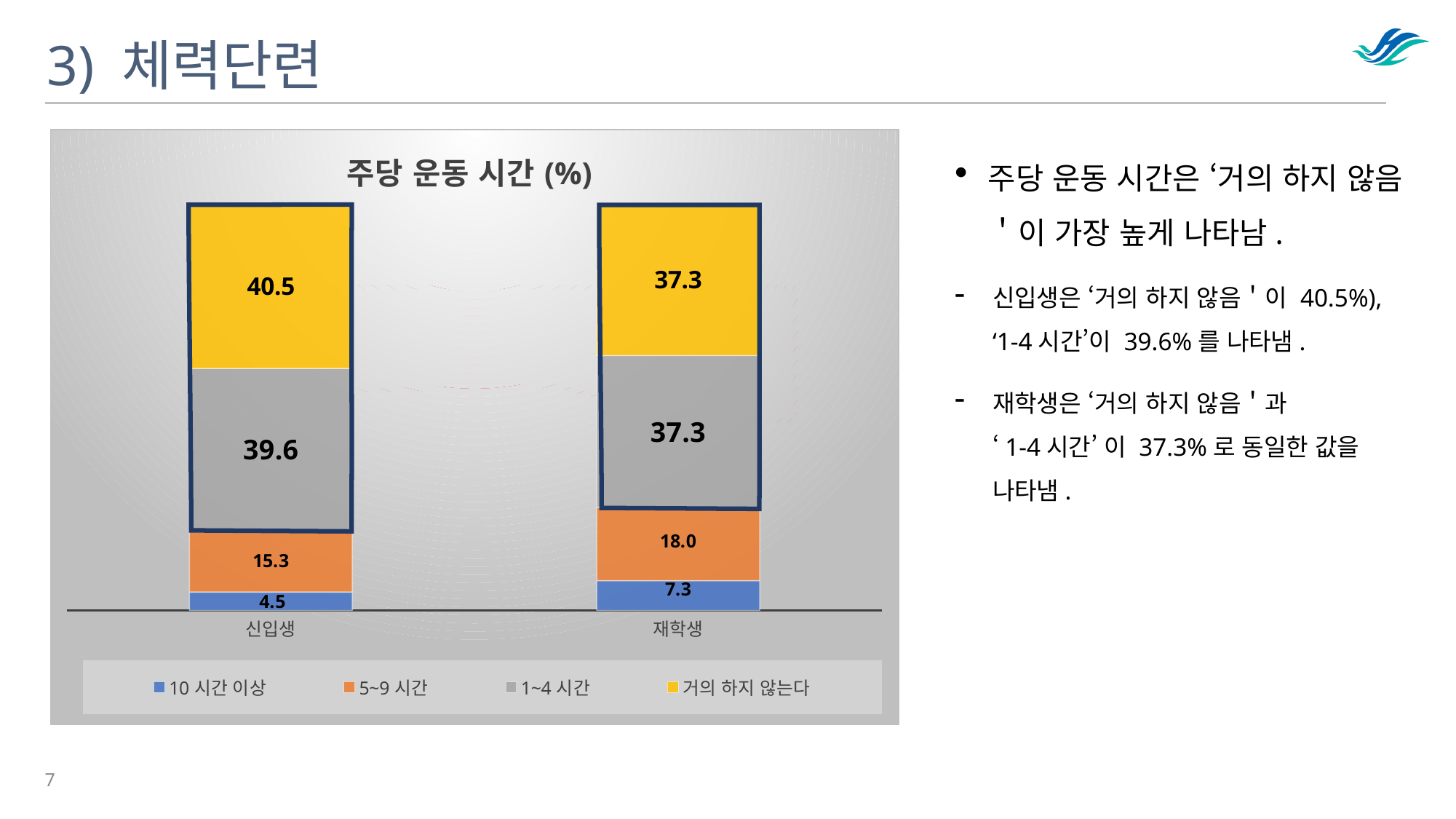
What is the total of the stacked bar for 신입생? 99.9 How many categories are shown on the x axis? 2 What is the difference between the '1~4 시간' values for 신입생 and 재학생? 2.3 What is the value of '10 시간 이상' for 신입생? 4.5 What is the value of '1~4 시간' for 재학생? 37.3 Which category has the higher value for '5~9 시간', 신입생 or 재학생? 재학생 What is the difference between the '10 시간 이상' values for 재학생 and 신입생? 2.8 How many series does the legend list? 4 What is the value of '5~9 시간' for 재학생? 18.0 What kind of chart is shown on the slide? Stacked bar chart Which category has the higher value for '거의 하지 않는다', 신입생 or 재학생? 신입생 What is the value of '거의 하지 않는다' for 신입생? 40.5